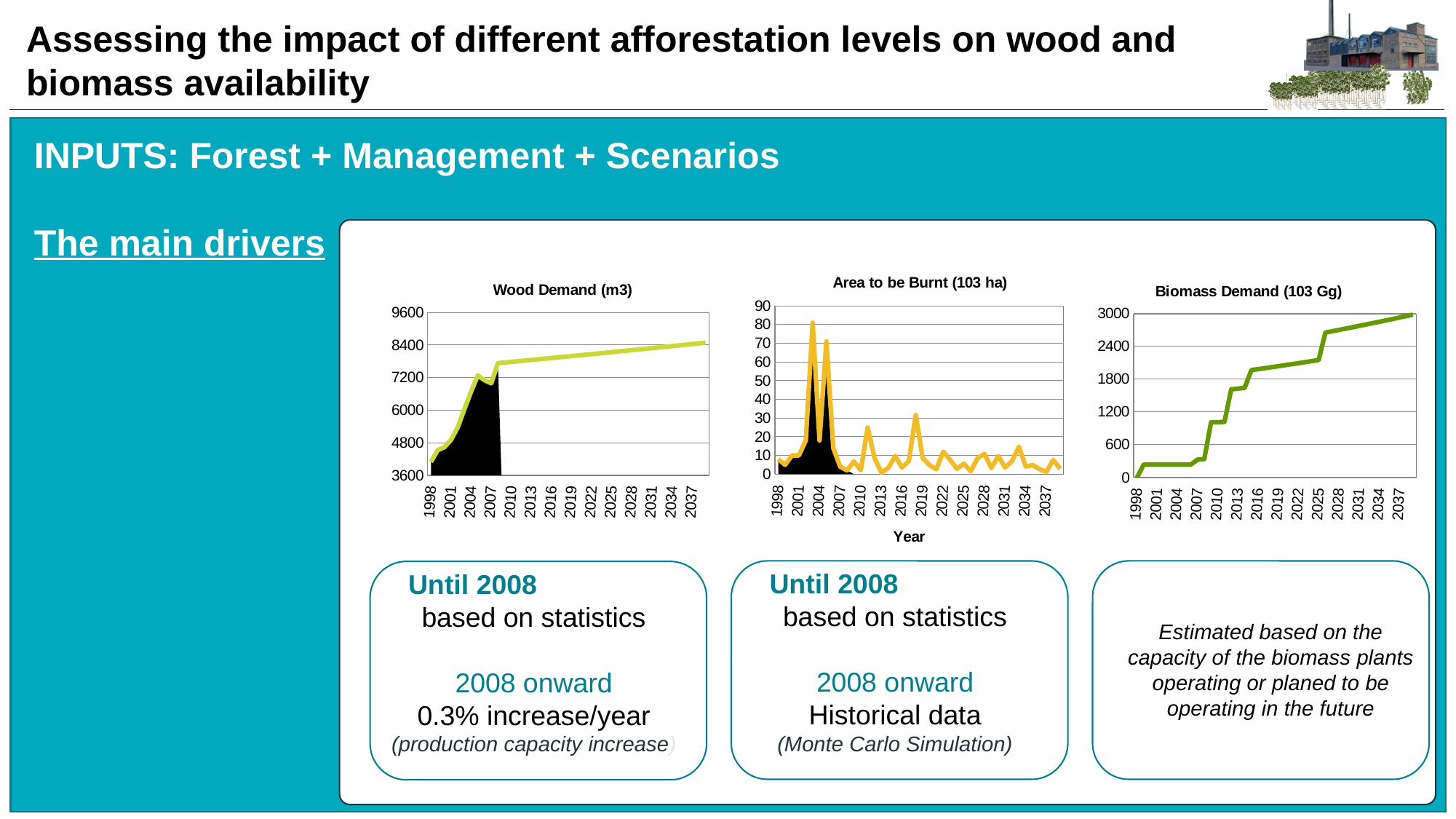
In the "Biomass Demand (103 Gg)" chart, is the value for 1998 greater or less than 600? less In the "Wood Demand (m3)" chart, is the value for 1998 greater or less than 4800? less In the "Area to be Burnt (103 ha)" chart, is the highest peak greater or less than 70? greater In the "Wood Demand (m3)" chart, do the values generally rise or fall from 1998 to 2037? rise How many charts are shown on the slide? 3 What is the x-axis label of the "Area to be Burnt (103 ha)" chart? Year What kind of chart is the "Biomass Demand (103 Gg)" chart? line chart In the "Biomass Demand (103 Gg)" chart, do the values rise or fall along the x axis? rise What kind of chart is the "Wood Demand (m3)" chart? area and line chart What is the title of the rightmost chart on the slide? Biomass Demand (103 Gg)